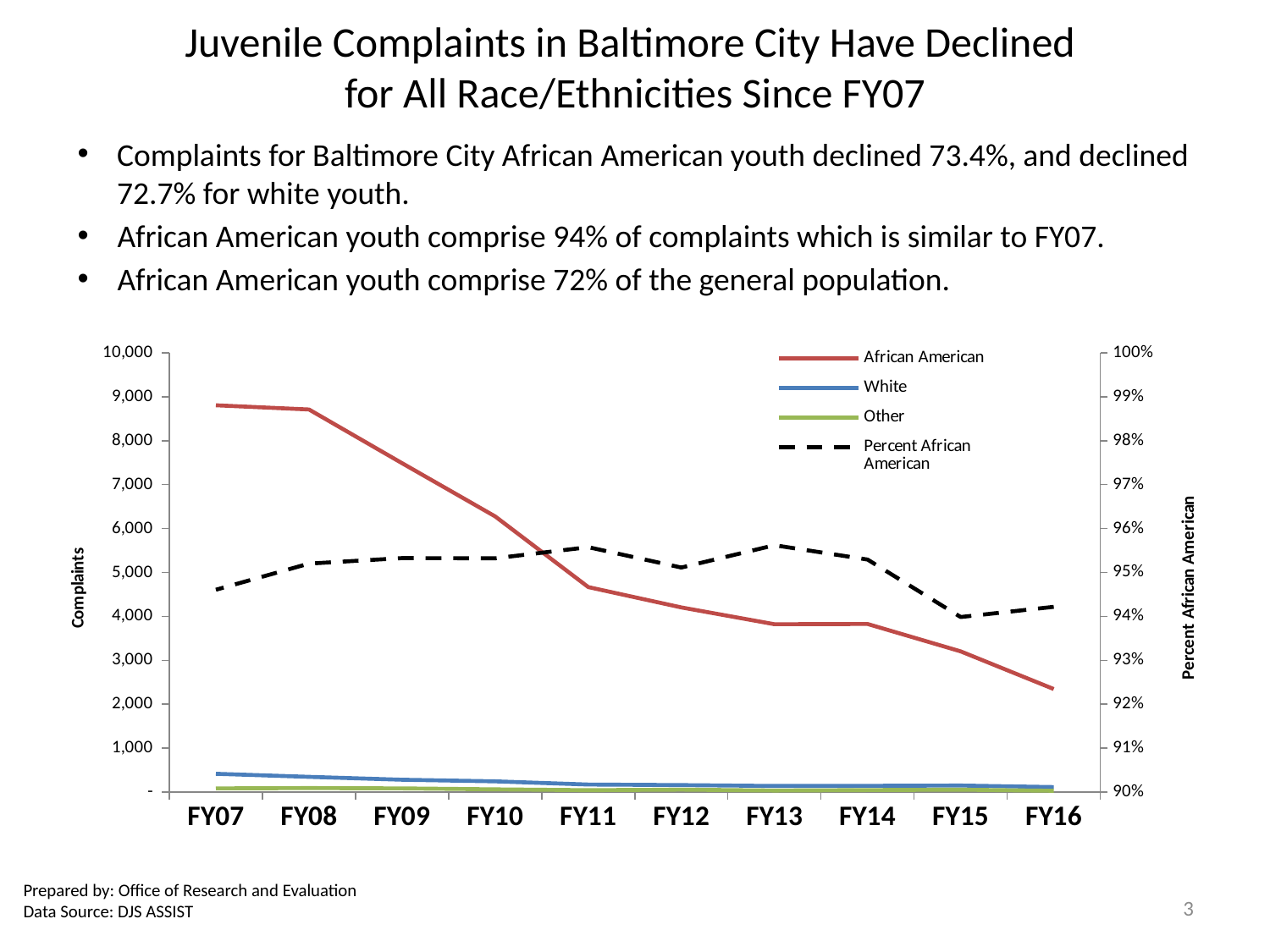
Which is larger, African American complaints in FY11 or in FY13? FY11 How many fiscal years are plotted along the x axis? 10 In which fiscal year are African American complaints highest? FY07 Is the value for African American complaints in FY16 greater or less than 3,000? less What kind of chart is shown on the slide? line chart Do African American complaints rise or fall from FY07 to FY16? fall Is the value for African American complaints in FY07 greater or less than 8,000? greater Which series is drawn as a dashed line? Percent African American How many series does the chart legend list? 4 In which fiscal year are African American complaints lowest? FY16 Is the value for White complaints in FY07 greater or less than 1,000? less